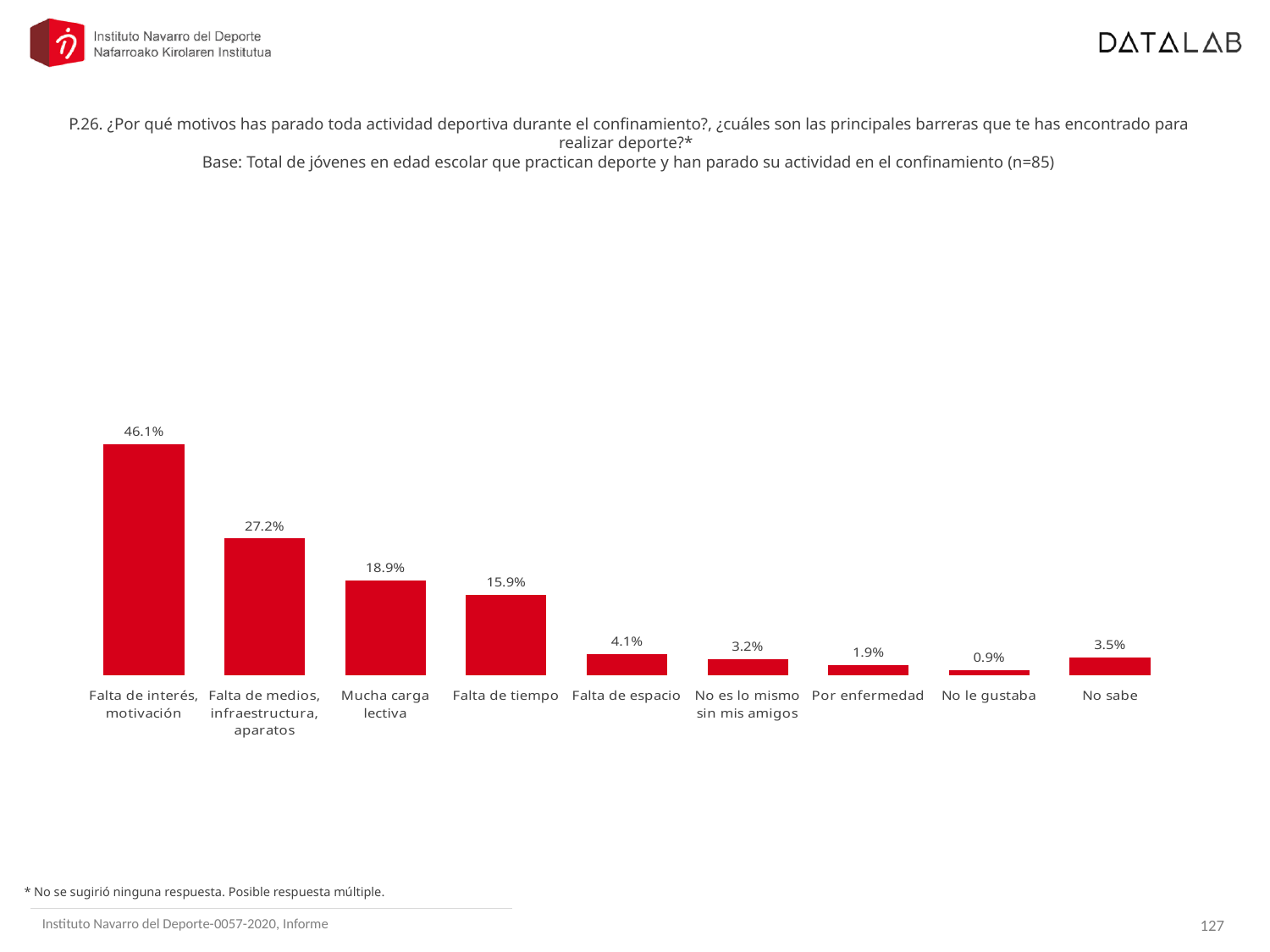
What is the value for "No sabe"? 3.5% What colour are the bars in the chart? Red What is the value for "Falta de interés, motivación"? 46.1% Which category has the highest value? Falta de interés, motivación What is the difference between "Falta de interés, motivación" and "Falta de medios, infraestructura, aparatos"? 18.9% What is the value for "Mucha carga lectiva"? 18.9% What is the value for "Por enfermedad"? 1.9% What kind of chart is shown on the slide? Bar chart What is the difference between "Falta de tiempo" and "Falta de espacio"? 11.8% How many categories are shown in the chart? 9 Which is larger, "No sabe" or "No es lo mismo sin mis amigos"? No sabe Which category has the lowest value? No le gustaba